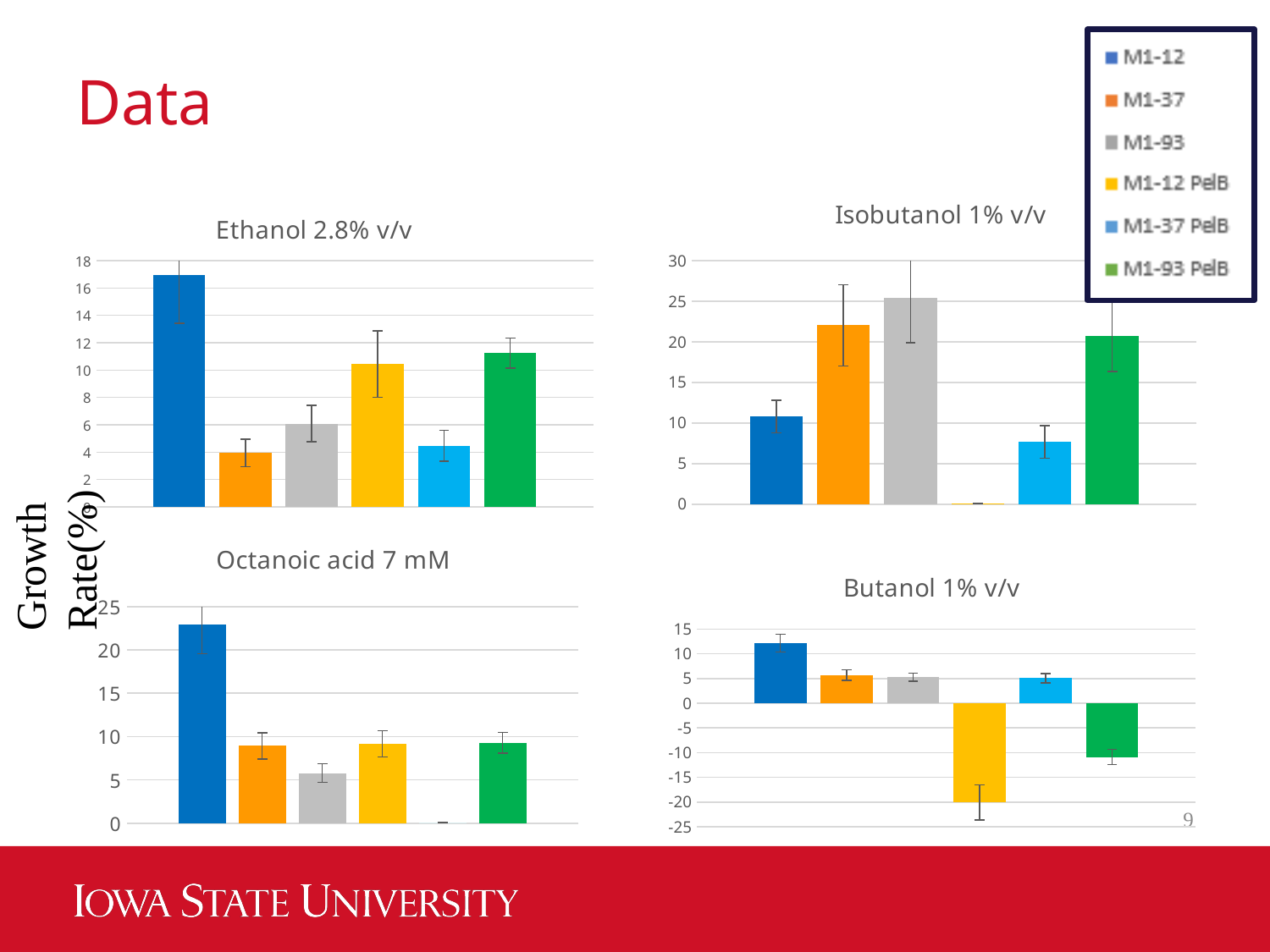
In the Butanol 1% v/v chart, which series has the lowest growth rate? M1-12 PelB In the Isobutanol 1% v/v chart, is the value for M1-37 PelB greater or less than 10? less In the Ethanol 2.8% v/v chart, is the value for M1-12 greater or less than 16? greater What kind of chart is the Ethanol 2.8% v/v chart? bar chart In the Butanol 1% v/v chart, is the value for M1-12 greater or less than 10? greater In the Octanoic acid 7 mM chart, which series has the lowest growth rate? M1-37 PelB In the Isobutanol 1% v/v chart, which series has the lowest growth rate? M1-12 PelB In the Octanoic acid 7 mM chart, which series has the highest growth rate? M1-12 How many series does the legend list? 6 In the Butanol 1% v/v chart, which is larger, the value for M1-12 or the value for M1-93 PelB? M1-12 In the Ethanol 2.8% v/v chart, which series has the highest growth rate? M1-12 In the Isobutanol 1% v/v chart, which series has the highest growth rate? M1-93